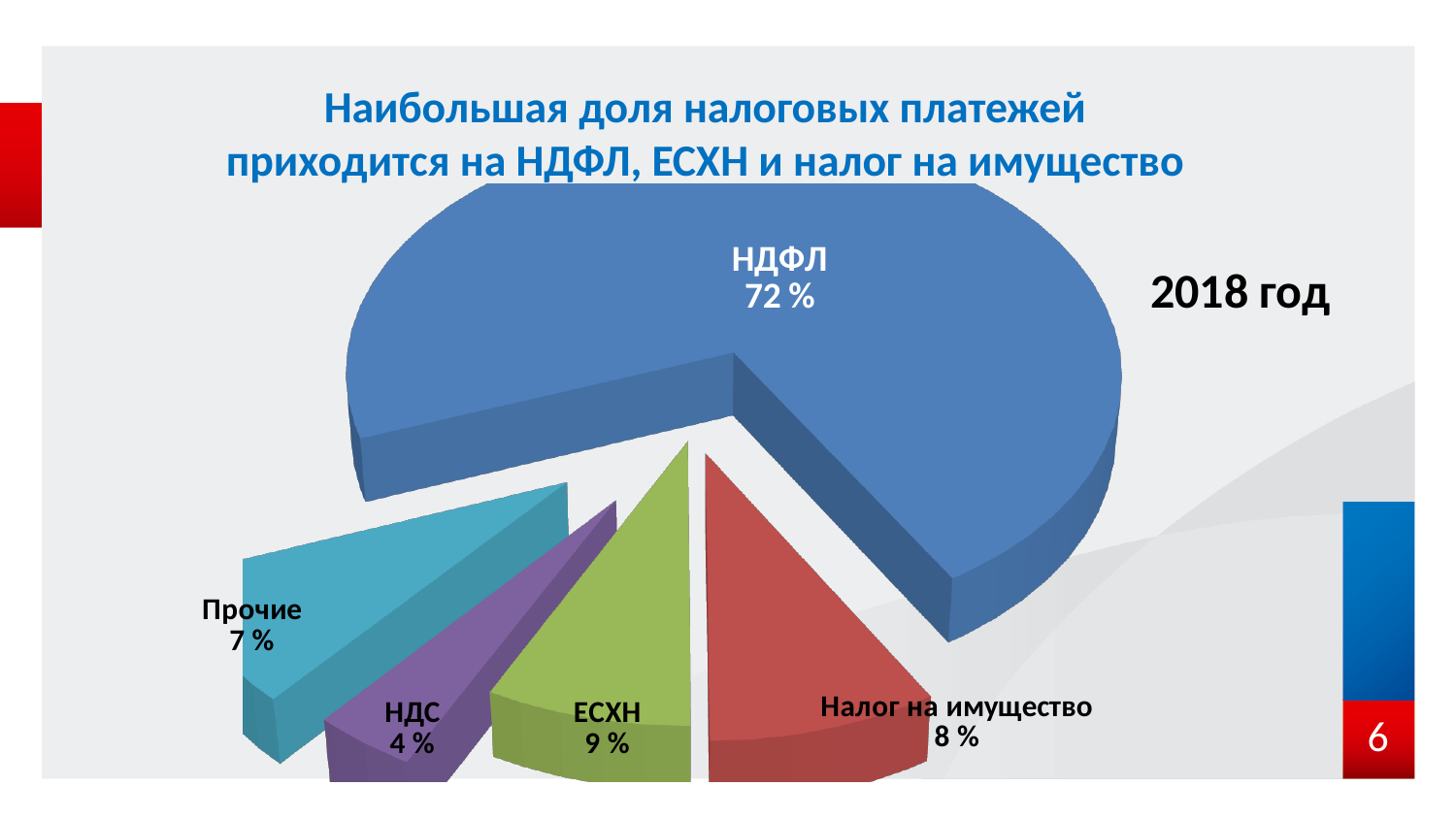
What is the difference between the share for НДФЛ and the share for ЕСХН? 63 % Which category has the largest share of the pie? НДФЛ What is the value shown for НДС? 4 % Which category has the smallest share of the pie? НДС What share of tax payments does НДФЛ account for? 72 % What is the value shown for Налог на имущество? 8 % Which is larger, the share for ЕСХН or the share for Налог на имущество? ЕСХН Which year does the pie chart refer to? 2018 год What is the value shown for Прочие? 7 % What is the value shown for ЕСХН? 9 % How many slices does the pie chart have? 5 What kind of chart is shown on the slide? Pie chart